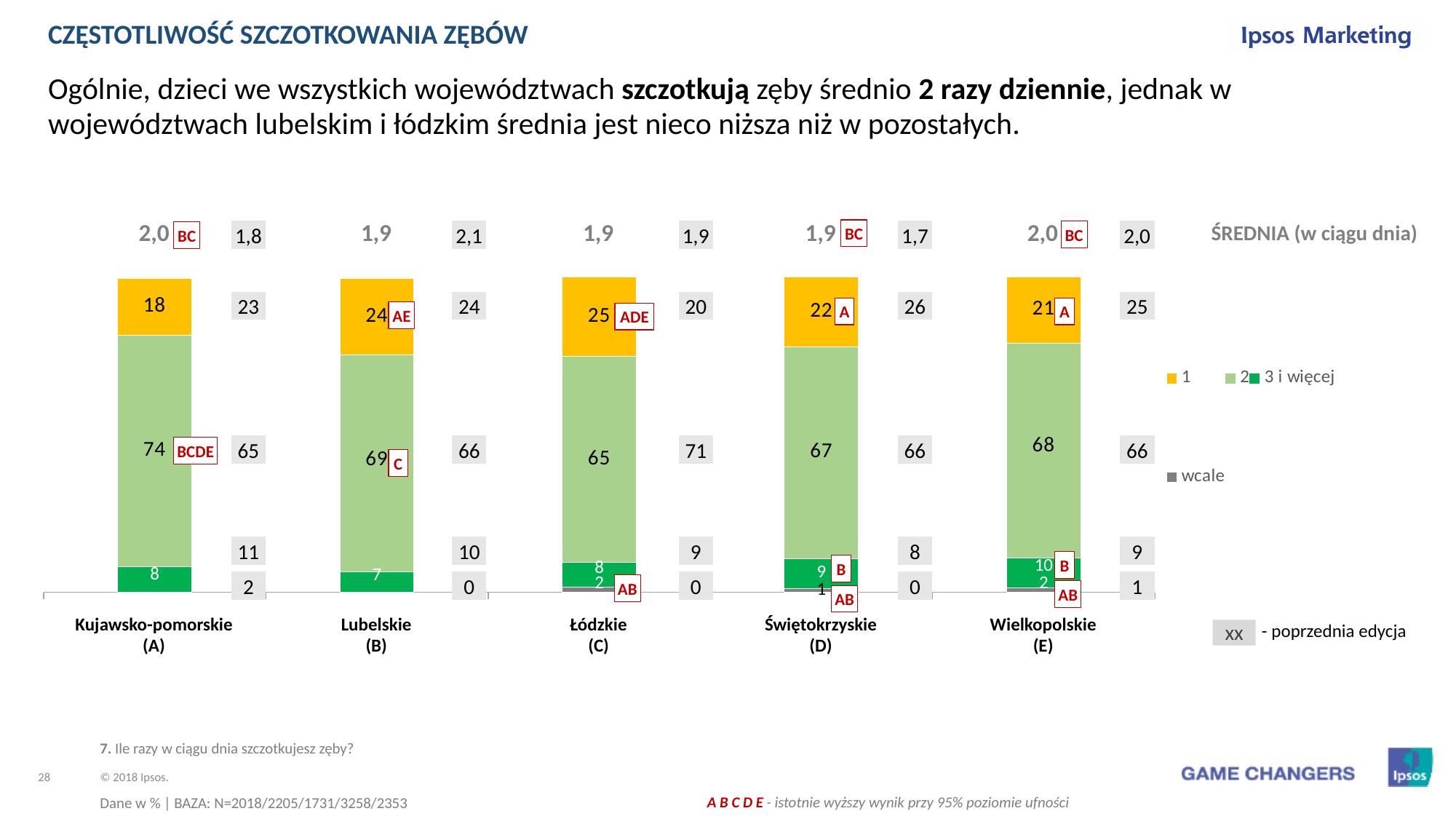
What is the value of the '2' series for Kujawsko-pomorskie (A)? 74 What is the ŚREDNIA (w ciągu dnia) value shown above the bar for Lubelskie (B)? 1,9 How many series does the legend list? 4 Which voivodeship has the lowest value for the '1' series? Kujawsko-pomorskie (A) What type of chart is shown on the slide? stacked bar chart How many voivodeships (categories) are shown on the x axis? 5 What is the value of the '1' series for Łódzkie (C)? 25 What colour represents the '1' series in the chart? yellow Which voivodeship has the highest value for the '2' series? Kujawsko-pomorskie (A) What is the difference between the '1' series values for Łódzkie (C) and Kujawsko-pomorskie (A)? 7 What is the value of the '3 i więcej' series for Wielkopolskie (E)? 10 Which is larger: the '3 i więcej' value for Lubelskie (B) or for Świętokrzyskie (D)? Świętokrzyskie (D)